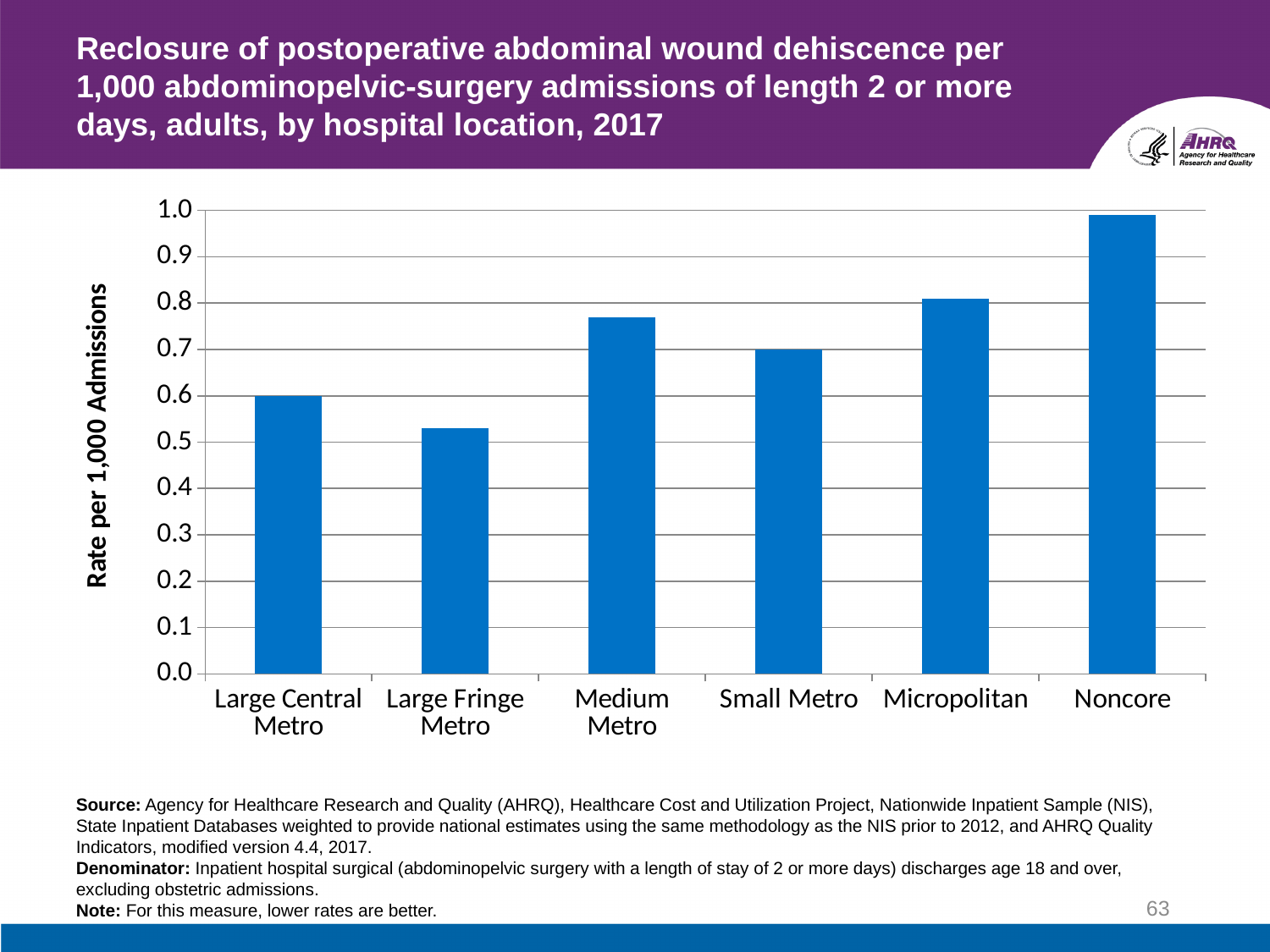
Is the value for Large Fringe Metro greater or less than 0.6? less How many hospital location categories are shown in the chart? 6 Is the value for Medium Metro greater or less than 0.7? greater Is the value for Noncore greater or less than 0.9? greater What is the label on the vertical axis of the chart? Rate per 1,000 Admissions Which hospital location has the lowest rate of reclosure of postoperative abdominal wound dehiscence? Large Fringe Metro What is the rate per 1,000 admissions for Large Central Metro hospitals? 0.6 Which hospital location has the highest rate of reclosure of postoperative abdominal wound dehiscence? Noncore What type of chart is shown on the slide? Bar chart What is the rate per 1,000 admissions for Small Metro hospitals? 0.7 Which has a higher rate, Medium Metro or Small Metro? Medium Metro